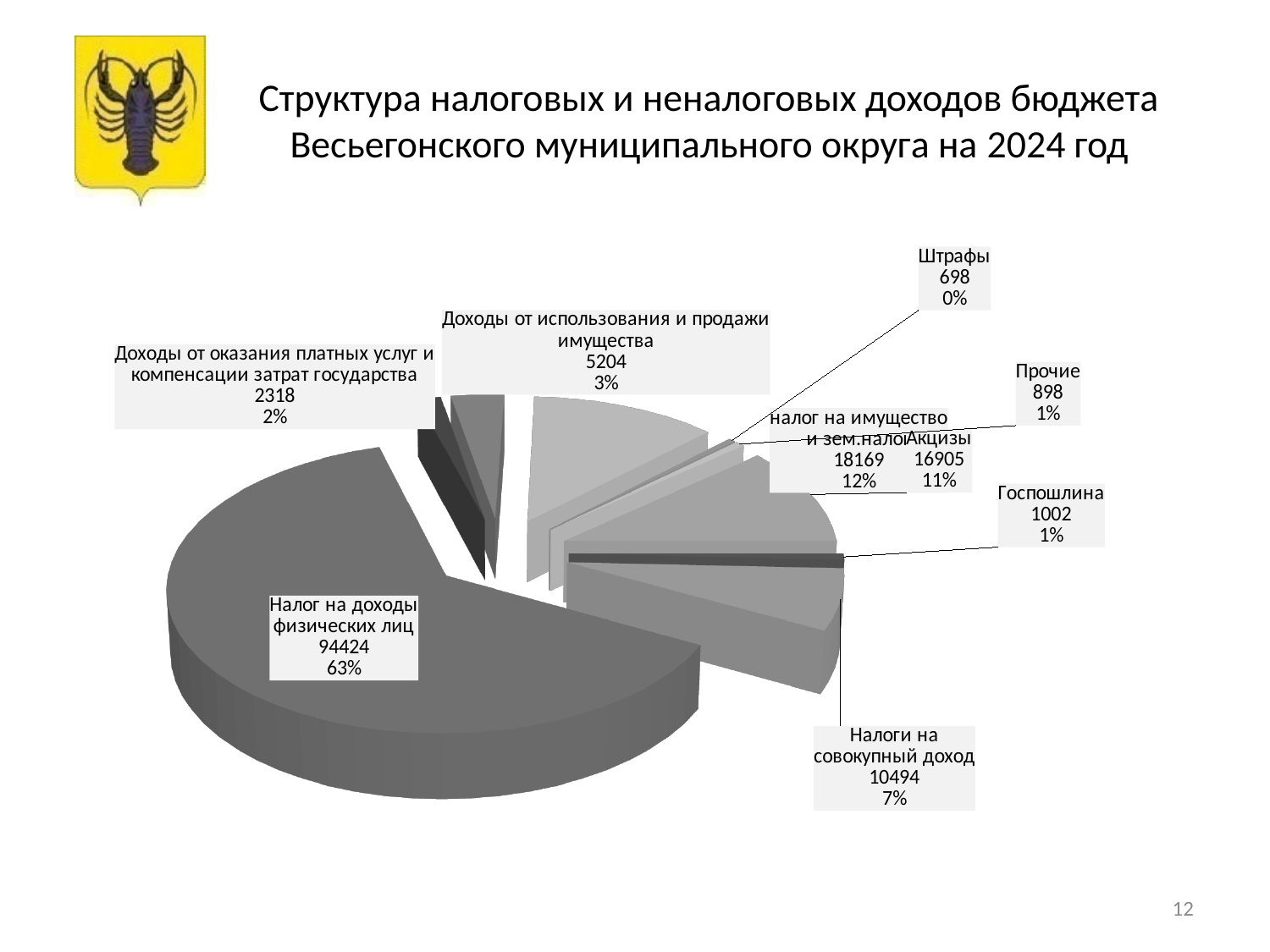
How many slices does the pie chart have? 9 What share of the pie does Доходы от использования и продажи имущества represent? 3% What is the value for Налог на доходы физических лиц? 94424 Which category has the largest slice of the pie? Налог на доходы физических лиц What share of the pie does налог на имущество и зем.налог represent? 12% What is the value for Госпошлина? 1002 Which category has the smallest value? Штрафы What is the value for Акцизы? 16905 What is the value for Налоги на совокупный доход? 10494 What kind of chart is shown on the slide? pie chart Which is larger, the value for Прочие or the value for Штрафы? Прочие What is the difference between the values for налог на имущество и зем.налог and Акцизы? 1264